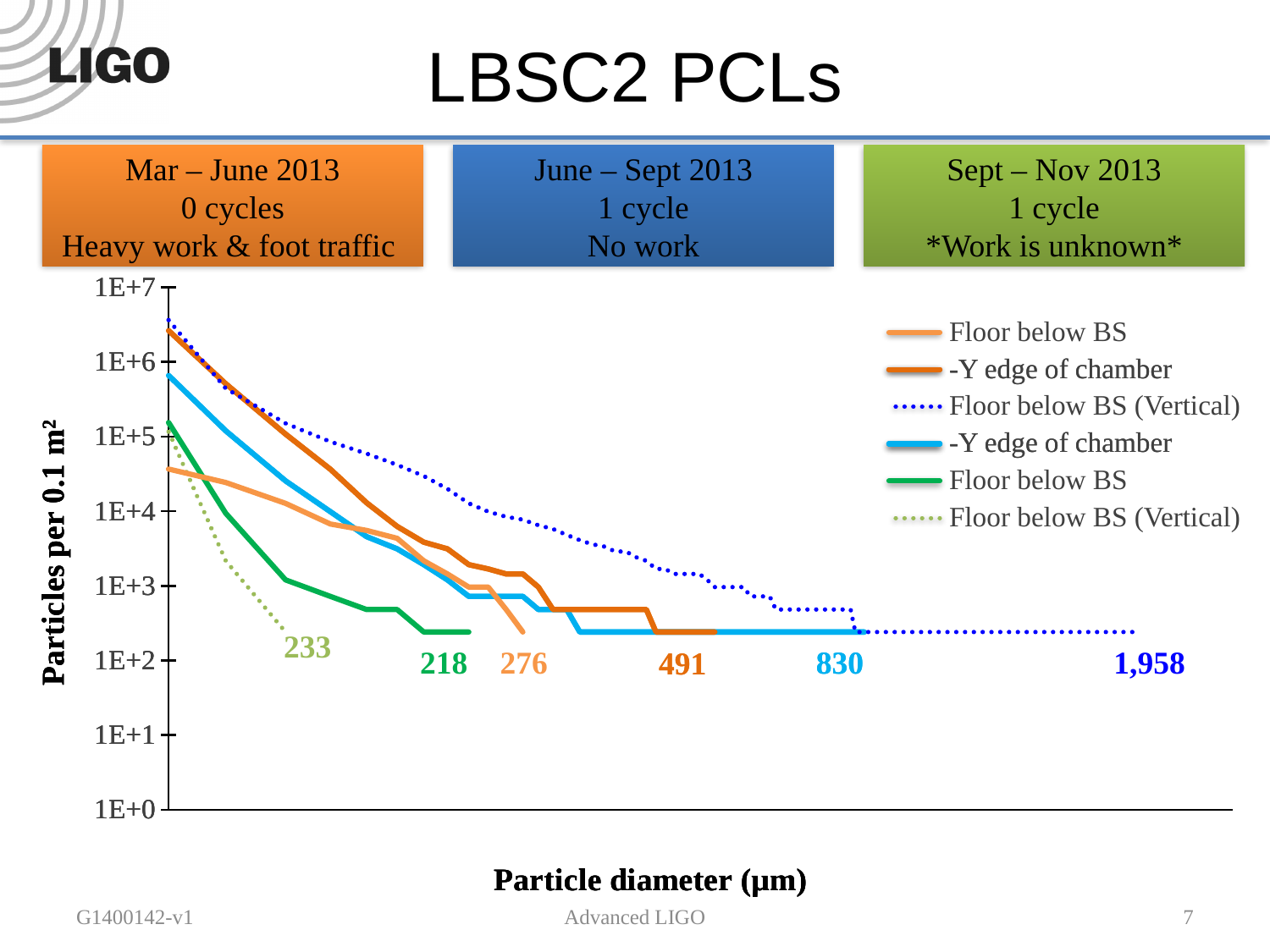
What is the largest particle diameter label printed on the chart? 1,958 What diameter label is printed at the end of the light blue -Y edge of chamber line? 830 What diameter label is printed at the end of the dark orange -Y edge of chamber line? 491 Is the starting value of the dark orange -Y edge of chamber line greater or less than 1E+6? greater How many series does the chart legend list? 6 Which is larger, the diameter label on the dark orange line (491) or the one on the light orange line (276)? 491 What is the smallest particle diameter label printed on the chart? 218 What kind of chart is shown on the slide? line chart What is the title of the x axis of the chart? Particle diameter (µm) Do the particle counts rise or fall as particle diameter increases along the x axis? fall What is the title of the y axis of the chart? Particles per 0.1 m² What is the difference between the diameter labels 830 and 491? 339